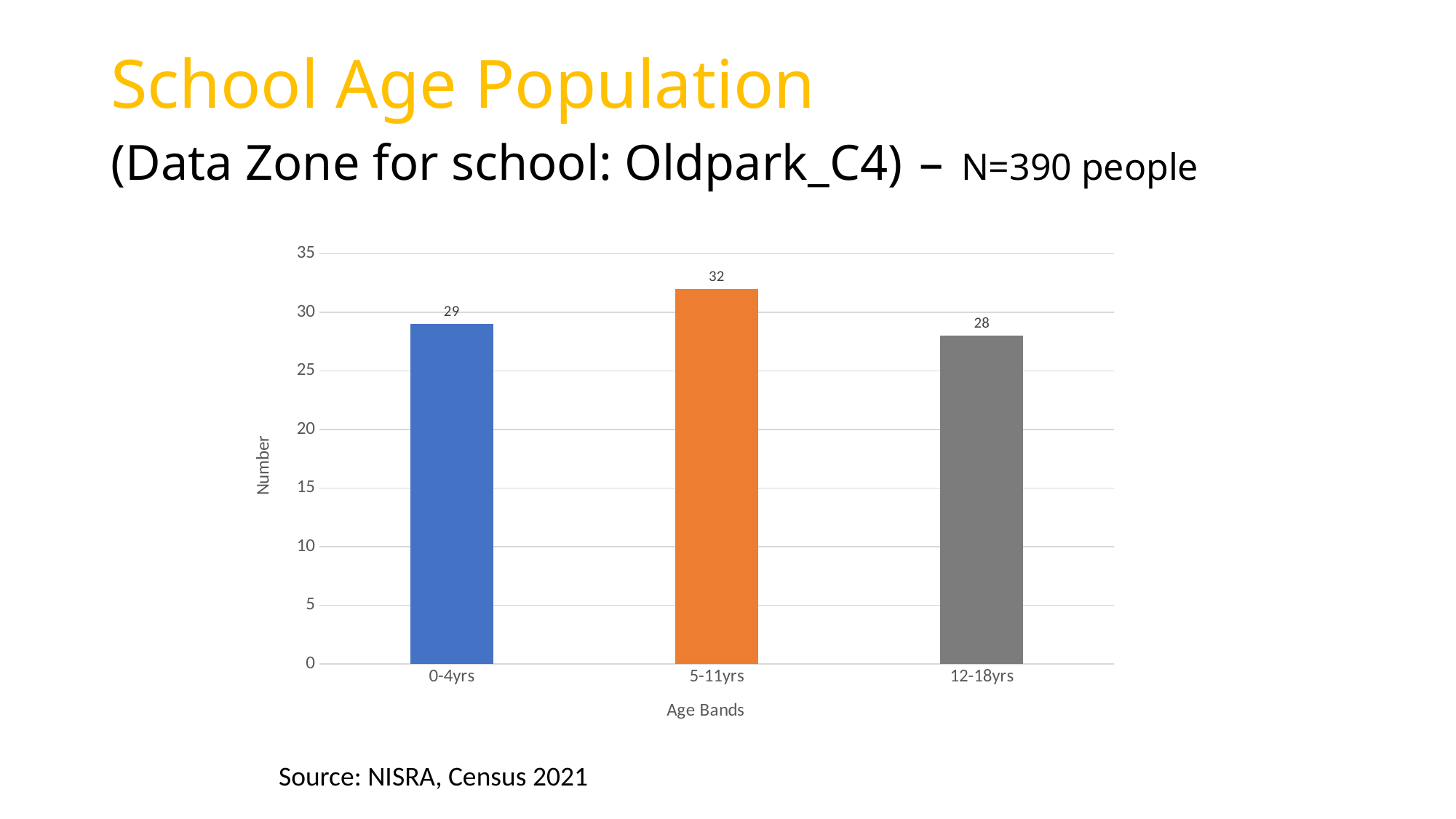
Is the value for 5-11yrs greater or less than 30? greater What kind of chart is shown on the slide? bar chart Which age band has the lowest value? 12-18yrs Which is larger, the value for 0-4yrs or the value for 5-11yrs? 5-11yrs What is the label of the x axis? Age Bands What is the difference between the values for 5-11yrs and 12-18yrs? 4 What is the value for the 12-18yrs age band? 28 What is the difference between the values for 5-11yrs and 0-4yrs? 3 Which age band has the highest value? 5-11yrs What is the value for the 5-11yrs age band? 32 How many age bands are shown on the chart? 3 What is the value for the 0-4yrs age band? 29